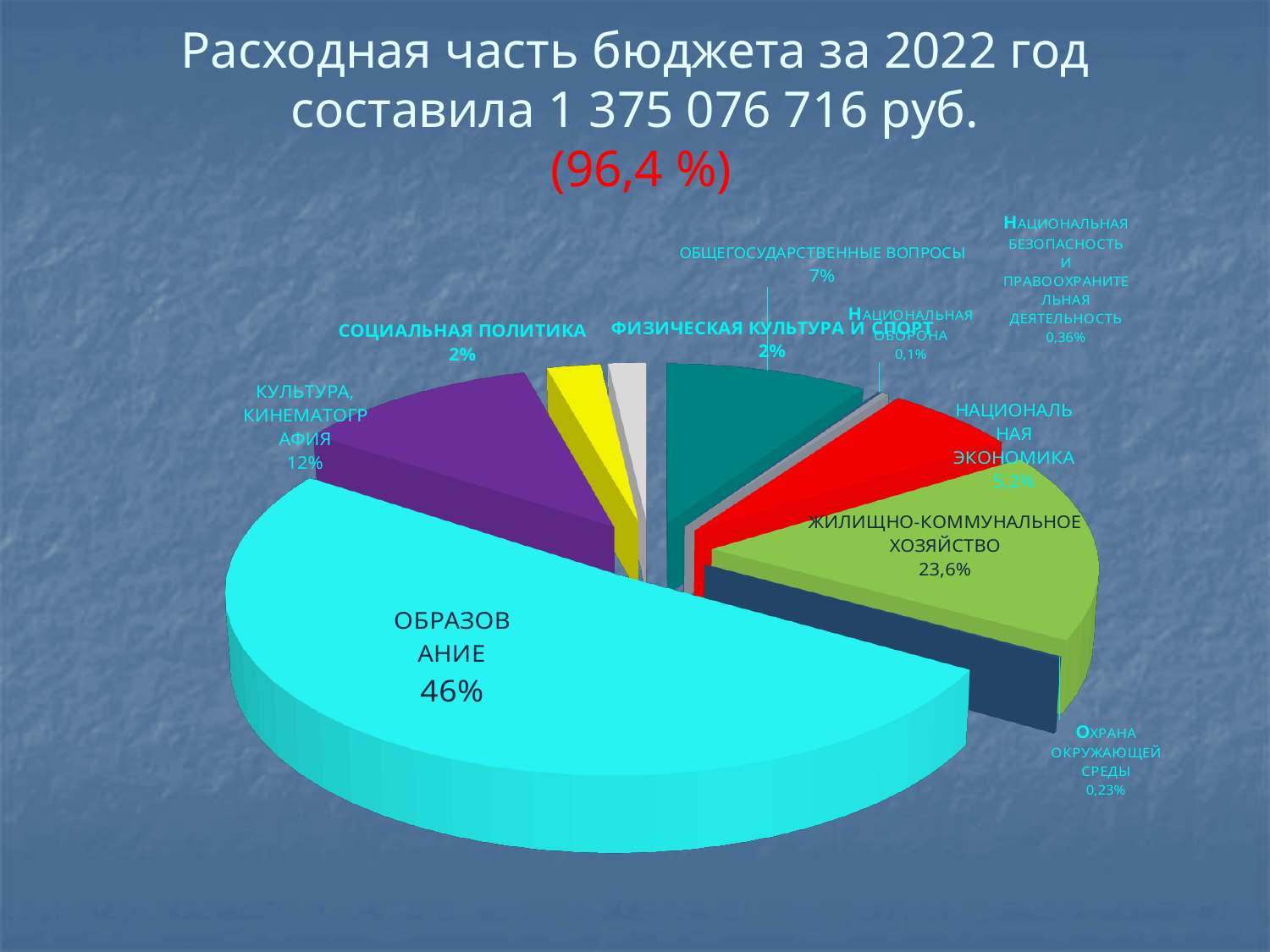
Which category has the smallest share of the pie? НАЦИОНАЛЬНАЯ ОБОРОНА What kind of chart is shown on the slide? Pie chart What share of the pie does ОБРАЗОВАНИЕ have? 46% What percentage is shown for ОХРАНА ОКРУЖАЮЩЕЙ СРЕДЫ? 0,23% What percentage is shown for КУЛЬТУРА, КИНЕМАТОГРАФИЯ? 12% What percentage is shown for НАЦИОНАЛЬНАЯ ЭКОНОМИКА? 5,2% What is the difference in percentage points between ОБРАЗОВАНИЕ and ЖИЛИЩНО-КОММУНАЛЬНОЕ ХОЗЯЙСТВО? 22,4 How many categories are shown in the pie chart? 10 Which has a larger share: ЖИЛИЩНО-КОММУНАЛЬНОЕ ХОЗЯЙСТВО or КУЛЬТУРА, КИНЕМАТОГРАФИЯ? ЖИЛИЩНО-КОММУНАЛЬНОЕ ХОЗЯЙСТВО What percentage is shown for ОБЩЕГОСУДАРСТВЕННЫЕ ВОПРОСЫ? 7% Which category has the largest share of the pie? ОБРАЗОВАНИЕ What share is shown for ЖИЛИЩНО-КОММУНАЛЬНОЕ ХОЗЯЙСТВО? 23,6%